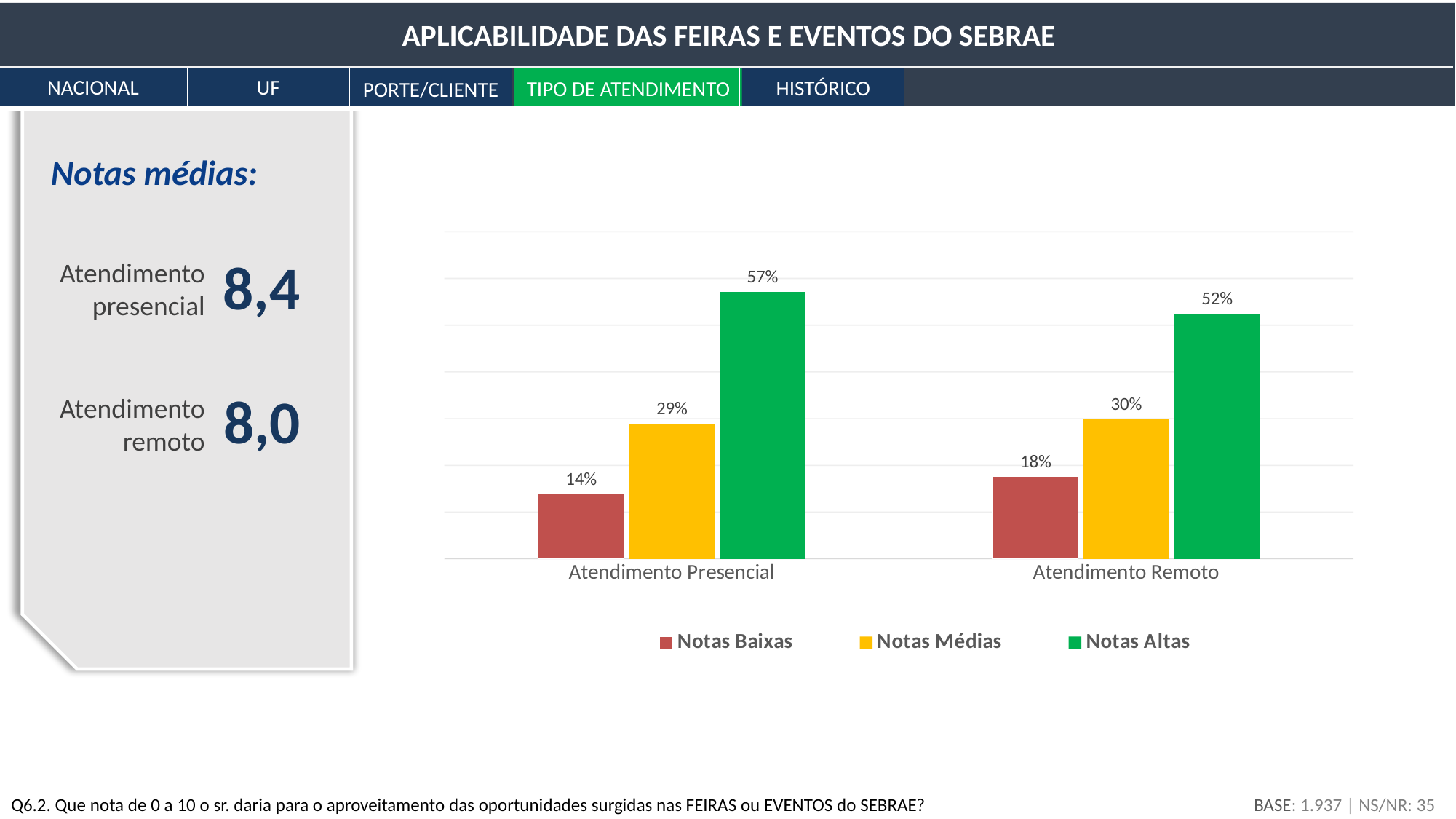
What kind of chart is shown on the slide? Bar chart What colour represents Notas Altas in the chart? Green What is the value of Notas Médias for Atendimento Presencial? 29% What is the value of Notas Baixas for Atendimento Remoto? 18% How many categories are shown on the x axis of the chart? 2 What is the difference between Notas Altas for Atendimento Presencial and Notas Altas for Atendimento Remoto? 5% How many series does the legend list? 3 What is the value of Notas Altas for Atendimento Presencial? 57% What is the value of Notas Altas for Atendimento Remoto? 52% Which series has the highest value for Atendimento Remoto? Notas Altas Which series has the lowest value for Atendimento Presencial? Notas Baixas Which is larger: Notas Baixas for Atendimento Presencial or Notas Baixas for Atendimento Remoto? Atendimento Remoto